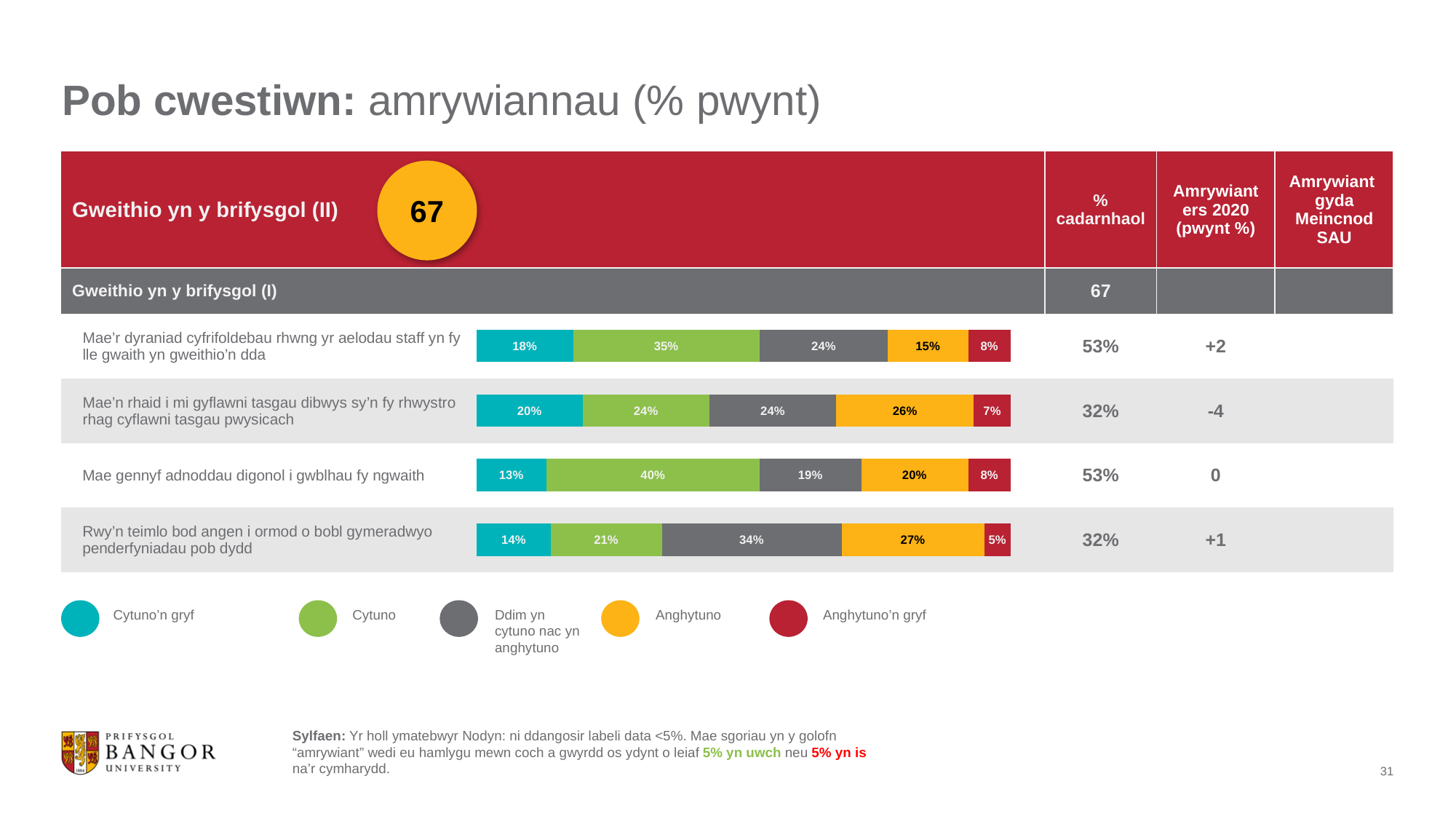
What is the 'Cytuno' value for 'Mae gennyf adnoddau digonol i gwblhau fy ngwaith'? 40% Which statement has the highest 'Cytuno'n gryf' value? Mae'n rhaid i mi gyflawni tasgau dibwys sy'n fy rhwystro rhag cyflawni tasgau pwysicach What is the '% cadarnhaol' value for 'Mae'r dyraniad cyfrifoldebau rhwng yr aelodau staff yn fy lle gwaith yn gweithio'n dda'? 53% What is the difference between the 'Cytuno' values for 'Mae gennyf adnoddau digonol i gwblhau fy ngwaith' and 'Rwy'n teimlo bod angen i ormod o bobl gymeradwyo penderfyniadau pob dydd'? 19% What is the 'Anghytuno' value for 'Mae'n rhaid i mi gyflawni tasgau dibwys sy'n fy rhwystro rhag cyflawni tasgau pwysicach'? 26% How many series does the legend list? 5 What is the 'Ddim yn cytuno nac yn anghytuno' value for 'Rwy'n teimlo bod angen i ormod o bobl gymeradwyo penderfyniadau pob dydd'? 34% Which statement has the lowest 'Anghytuno'n gryf' value? Rwy'n teimlo bod angen i ormod o bobl gymeradwyo penderfyniadau pob dydd What is the 'Amrywiant ers 2020 (pwynt %)' value for 'Mae'n rhaid i mi gyflawni tasgau dibwys sy'n fy rhwystro rhag cyflawni tasgau pwysicach'? -4 Which is larger: the 'Anghytuno' value for 'Mae'r dyraniad cyfrifoldebau rhwng yr aelodau staff yn fy lle gwaith yn gweithio'n dda' or for 'Mae gennyf adnoddau digonol i gwblhau fy ngwaith'? Mae gennyf adnoddau digonol i gwblhau fy ngwaith How many statements (bars) are plotted on the slide? 4 What kind of chart is used to show the responses to each statement? Stacked bar chart